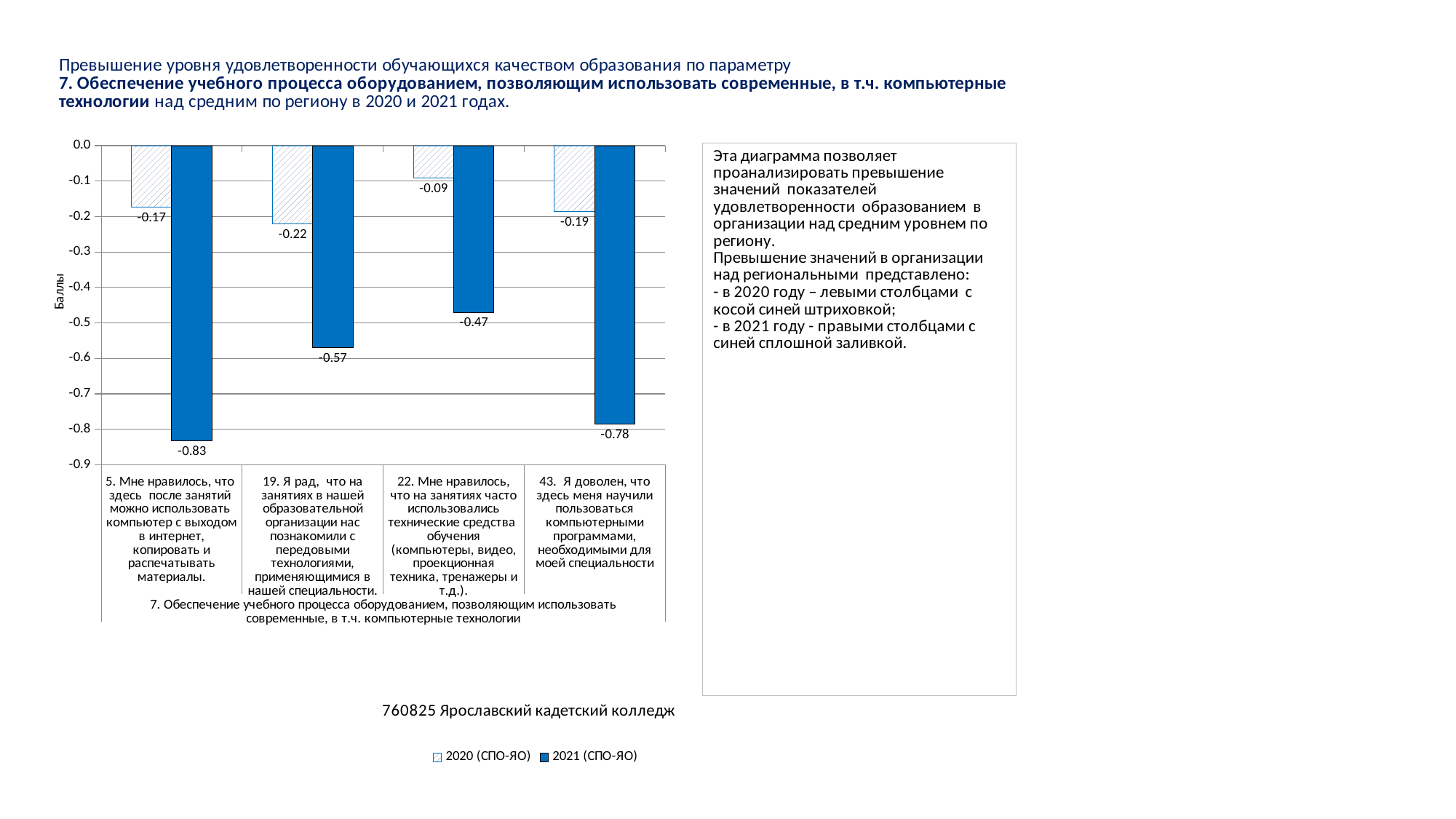
Which category has the highest 2020 (СПО-ЯО) value? 22. Мне нравилось, что на занятиях часто использовались технические средства обучения (компьютеры, видео, проекционная техника, тренажеры и т.д.). What is the 2021 (СПО-ЯО) value for category 5 ("Мне нравилось, что здесь после занятий можно использовать компьютер...")? -0.83 How many series does the chart legend list? 2 What is the 2020 (СПО-ЯО) value for category 19 ("Я рад, что на занятиях в нашей образовательной организации нас познакомили с передовыми технологиями...")? -0.22 What is the difference between the 2020 and 2021 (СПО-ЯО) values for category 22? 0.38 What is the 2021 (СПО-ЯО) value for category 43 ("Я доволен, что здесь меня научили пользоваться компьютерными программами...")? -0.78 What is the 2020 (СПО-ЯО) value for category 22 ("Мне нравилось, что на занятиях часто использовались технические средства обучения...")? -0.09 For category 19, which is larger: the 2020 (СПО-ЯО) value or the 2021 (СПО-ЯО) value? 2020 (СПО-ЯО) What type of chart is shown on the slide? Bar chart How many categories (questions) are shown on the x axis of the chart? 4 Which category has the lowest 2021 (СПО-ЯО) value? 5. Мне нравилось, что здесь после занятий можно использовать компьютер с выходом в интернет, копировать и распечатывать материалы. What is the label of the y axis of the chart? Баллы